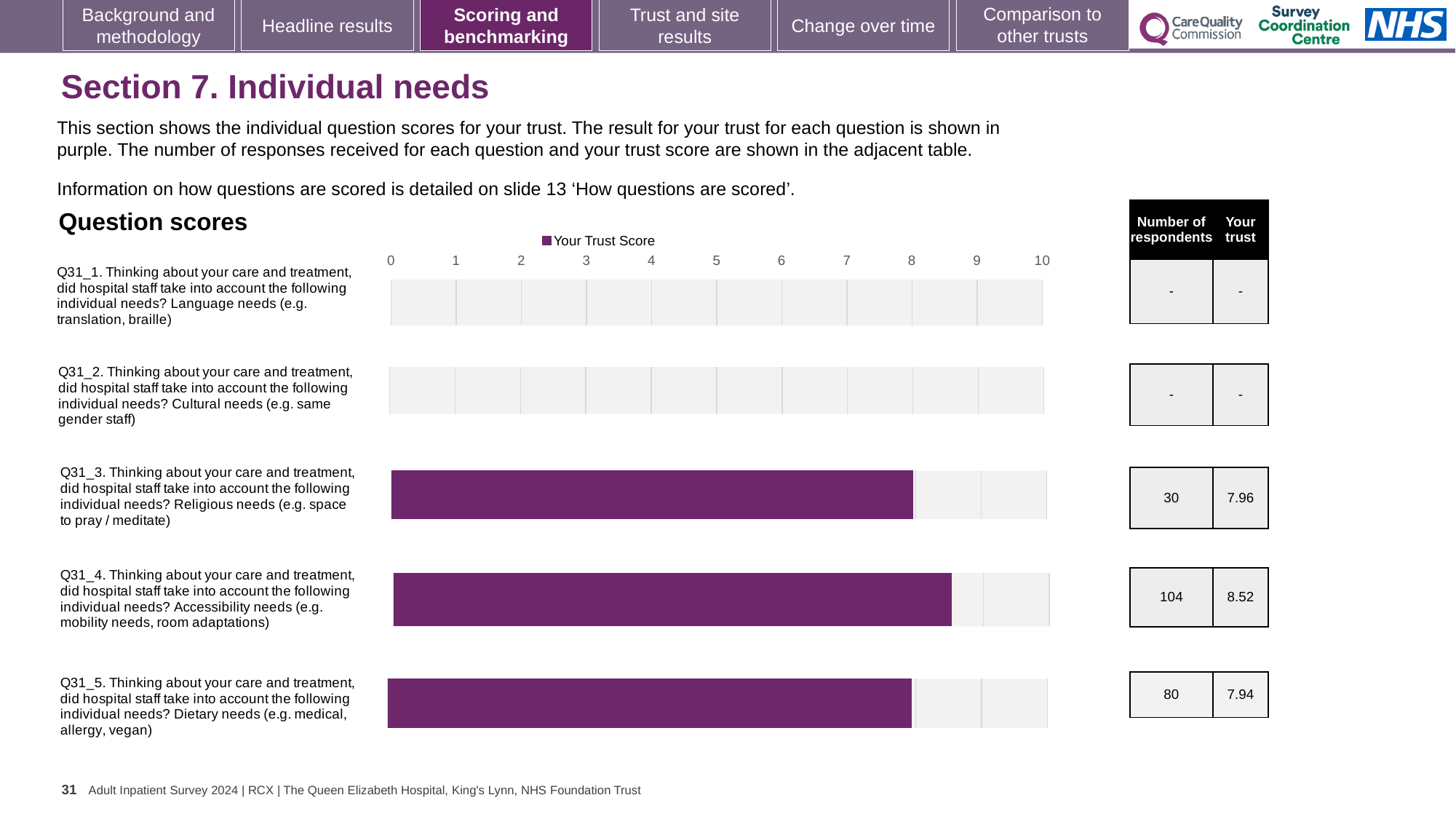
What is the trust score for Q31_4 (Accessibility needs)? 8.52 Is the value for Q31_4 (Accessibility needs) greater or less than 8? greater What is the difference between the trust scores for Q31_4 and Q31_3? 0.56 What kind of chart is shown on the slide? Bar chart What is the trust score for Q31_3 (Religious needs)? 7.96 Is the value for Q31_3 (Religious needs) greater or less than 7? greater How many questions are listed on the chart? 5 What is the legend entry shown above the chart? Your Trust Score What is the trust score for Q31_5 (Dietary needs)? 7.94 Which has a higher trust score, Q31_4 (Accessibility needs) or Q31_5 (Dietary needs)? Q31_4 (Accessibility needs) How many respondents answered Q31_4 (Accessibility needs)? 104 Which question has the highest trust score on the chart? Q31_4 (Accessibility needs)